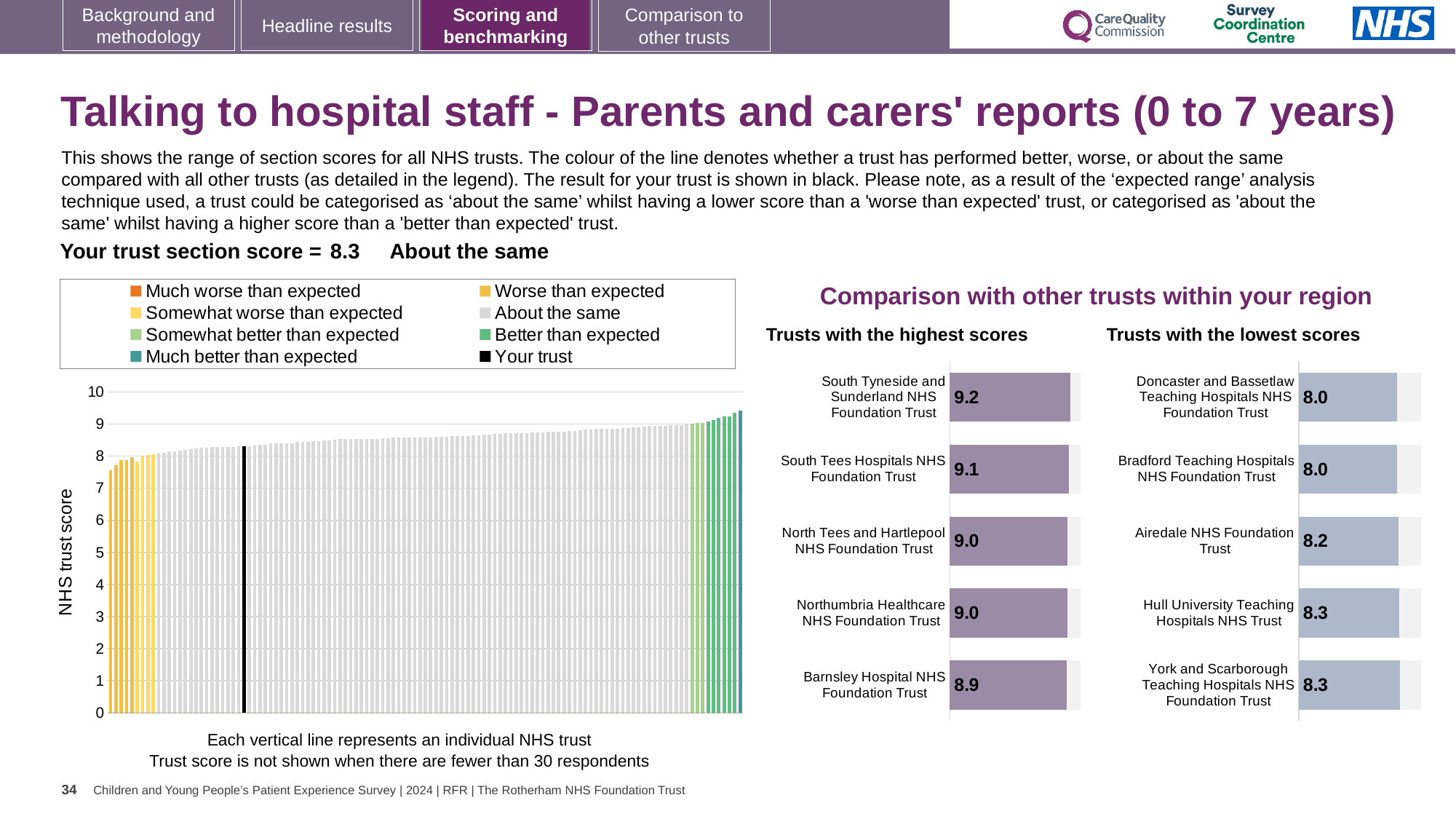
In the 'Trusts with the lowest scores' chart, which is larger: the score for Airedale NHS Foundation Trust or for Bradford Teaching Hospitals NHS Foundation Trust? Airedale NHS Foundation Trust In the 'Trusts with the lowest scores' chart, what is the score for Airedale NHS Foundation Trust? 8.2 In the 'Trusts with the highest scores' chart, what is the score for South Tyneside and Sunderland NHS Foundation Trust? 9.2 In the 'Trusts with the highest scores' chart, how many trusts are shown? 5 In the 'Trusts with the lowest scores' chart, what is the difference between the scores of Hull University Teaching Hospitals NHS Trust and Doncaster and Bassetlaw Teaching Hospitals NHS Foundation Trust? 0.3 In the 'Trusts with the lowest scores' chart, what is the score for Doncaster and Bassetlaw Teaching Hospitals NHS Foundation Trust? 8.0 In the 'Trusts with the highest scores' chart, what is the difference between the scores of South Tyneside and Sunderland NHS Foundation Trust and Barnsley Hospital NHS Foundation Trust? 0.3 In the large chart on the left, how many entries does the legend list? 8 What kind of chart is the large chart on the left showing NHS trust scores? Bar chart In the 'Trusts with the highest scores' chart, which trust has the lowest score? Barnsley Hospital NHS Foundation Trust In the large chart on the left, what is the label of the vertical axis? NHS trust score In the large chart on the left, is the value of the highest bar greater or less than 9? greater